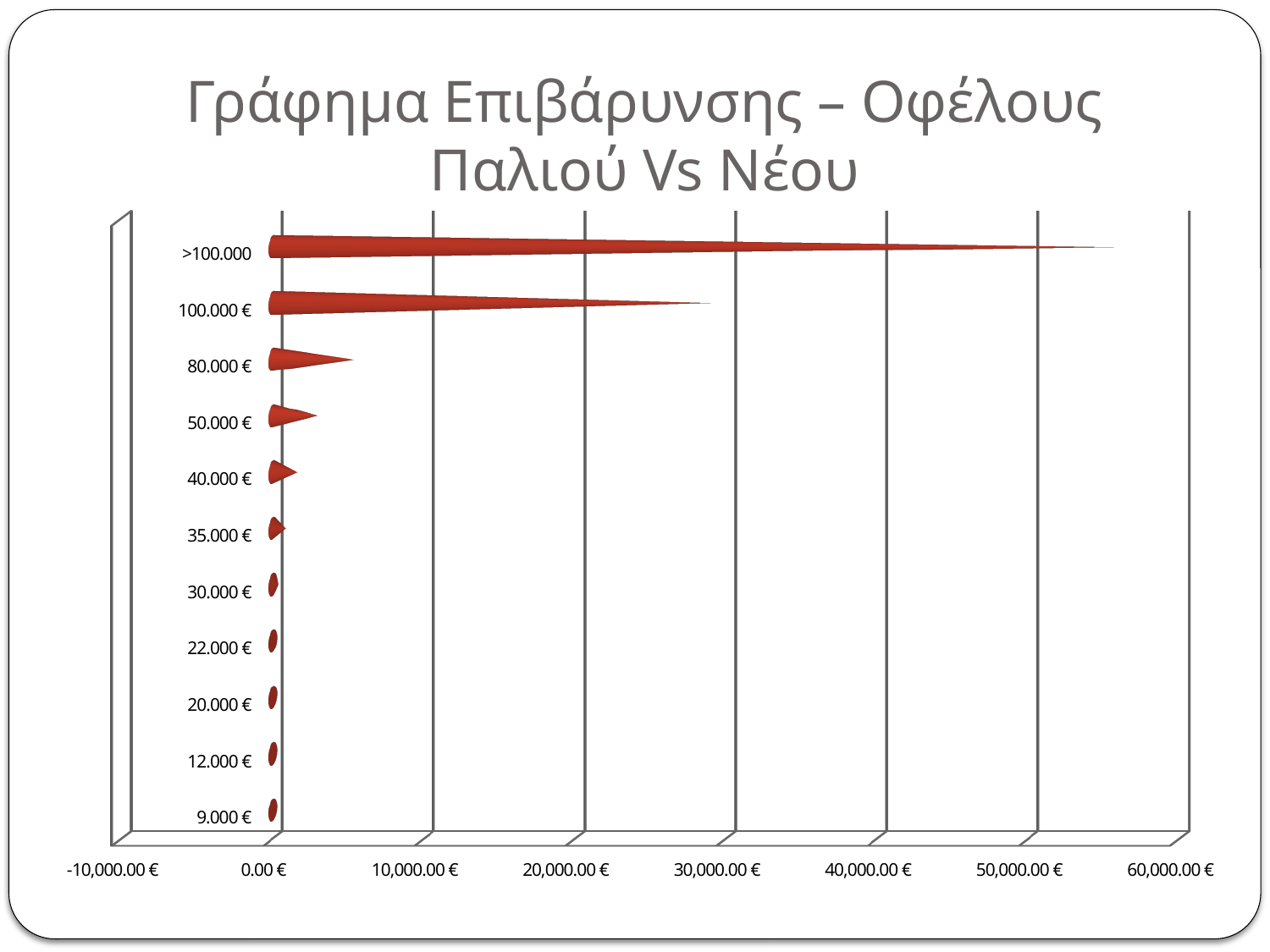
Which category has the highest value? >100.000 What is the highest value shown on the horizontal axis? 60,000.00 € What is the title of the chart? Γράφημα Επιβάρυνσης – Οφέλους Παλιού Vs Νέου What kind of chart is shown on the slide? bar chart Is the value for 100.000 € greater or less than 30,000.00 €? less Which is larger, the value for 80.000 € or the value for 50.000 €? 80.000 € Which is larger, the value for >100.000 or the value for 100.000 €? >100.000 Is the value for 100.000 € greater or less than 20,000.00 €? greater Do the bar values increase or decrease going from the top category to the bottom category? decrease Is the value for 80.000 € greater or less than 10,000.00 €? less How many categories are plotted on the chart? 11